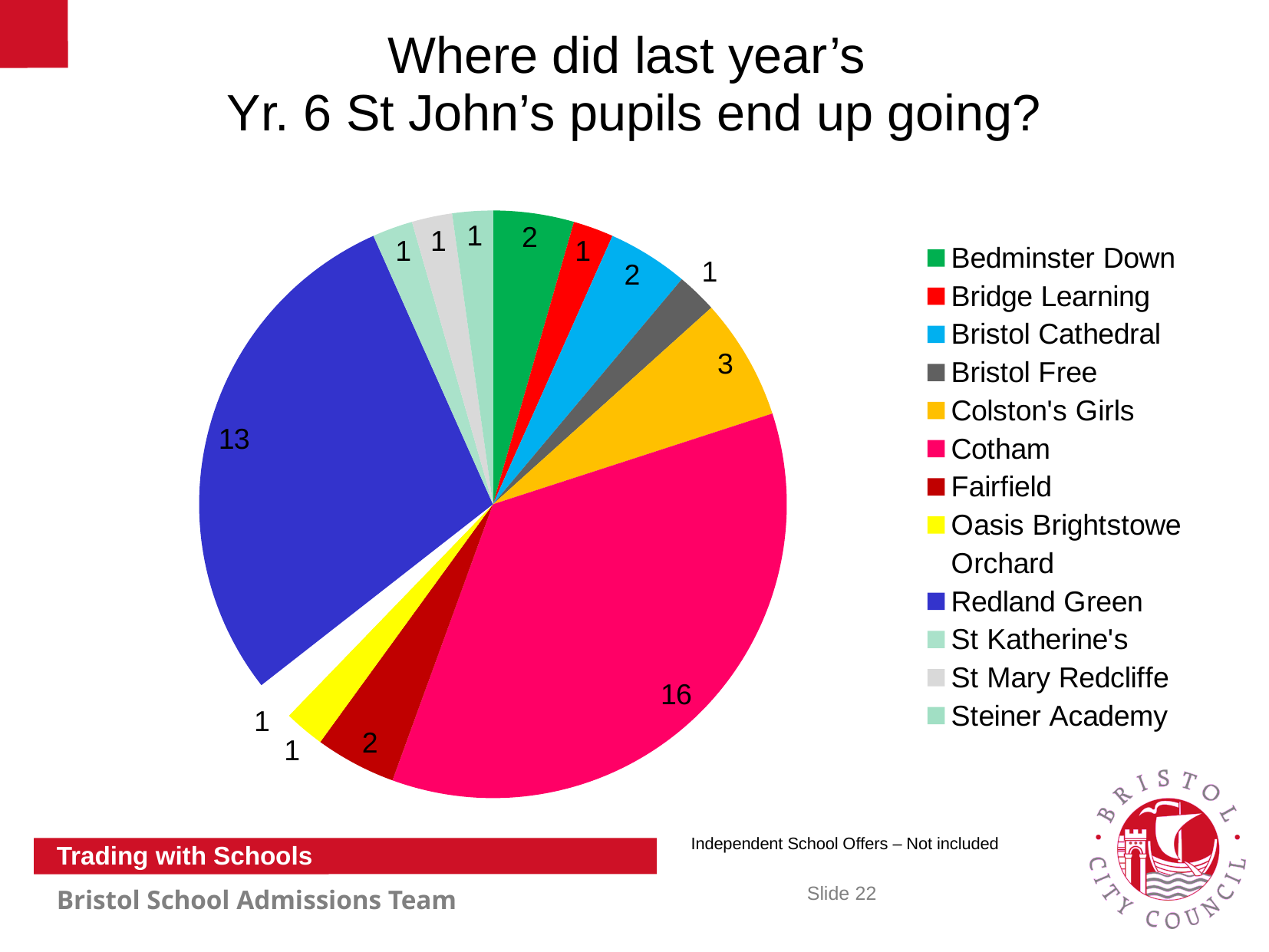
What is the difference between the values for Cotham and Redland Green? 3 What value is shown for Bristol Cathedral? 2 What value is shown for Fairfield? 2 What value is shown for Colston's Girls? 3 How many pupils went to Cotham according to the pie chart? 16 How many schools are listed in the legend? 13 Which school received the largest number of pupils? Cotham Which is larger, the value for Bedminster Down or the value for Colston's Girls? Colston's Girls What type of chart is shown on the slide? Pie chart What is the total of all the values shown on the pie chart? 45 What value is shown for Redland Green? 13 What is the title of the slide containing the chart? Where did last year's Yr. 6 St John's pupils end up going?